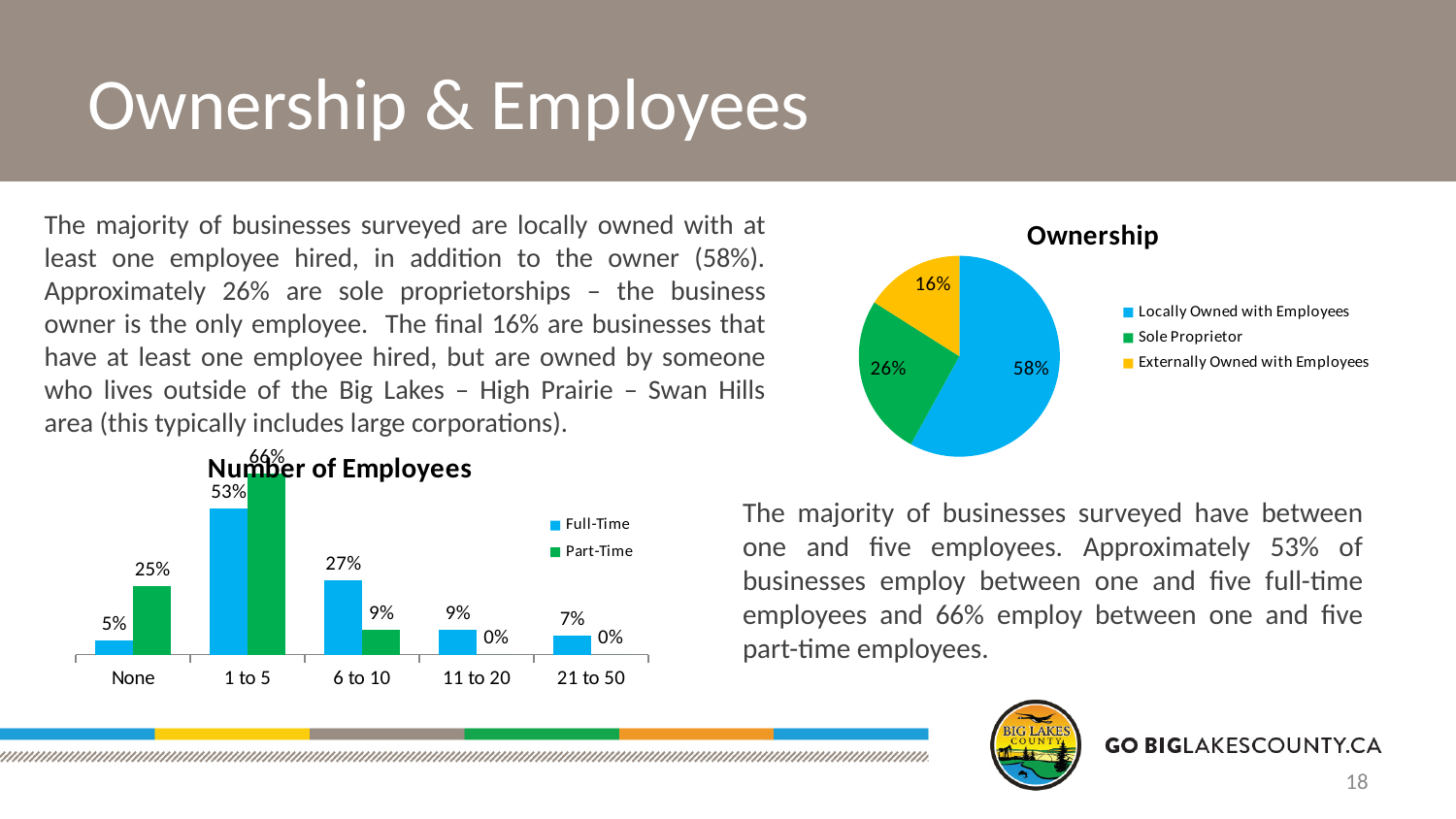
In the Ownership pie chart, what share is Sole Proprietor? 26% In the Number of Employees chart, is the Full-Time value for 11 to 20 larger or the Part-Time value for 11 to 20? Full-Time What type of chart is the Ownership chart? Pie chart In the Ownership pie chart, which category has the smallest slice? Externally Owned with Employees How many series does the legend of the Number of Employees chart list? 2 How many slices does the Ownership pie chart have? 3 In the Number of Employees chart, what is the Part-Time value for None? 25% What type of chart is the Number of Employees chart? Bar chart In the Number of Employees chart, which category has the highest Part-Time value? 1 to 5 In the Number of Employees chart, what is the Full-Time value for 1 to 5? 53% In the Number of Employees chart, what is the difference between the Full-Time and Part-Time values for 6 to 10? 18% In the Ownership pie chart, what share is Locally Owned with Employees? 58%